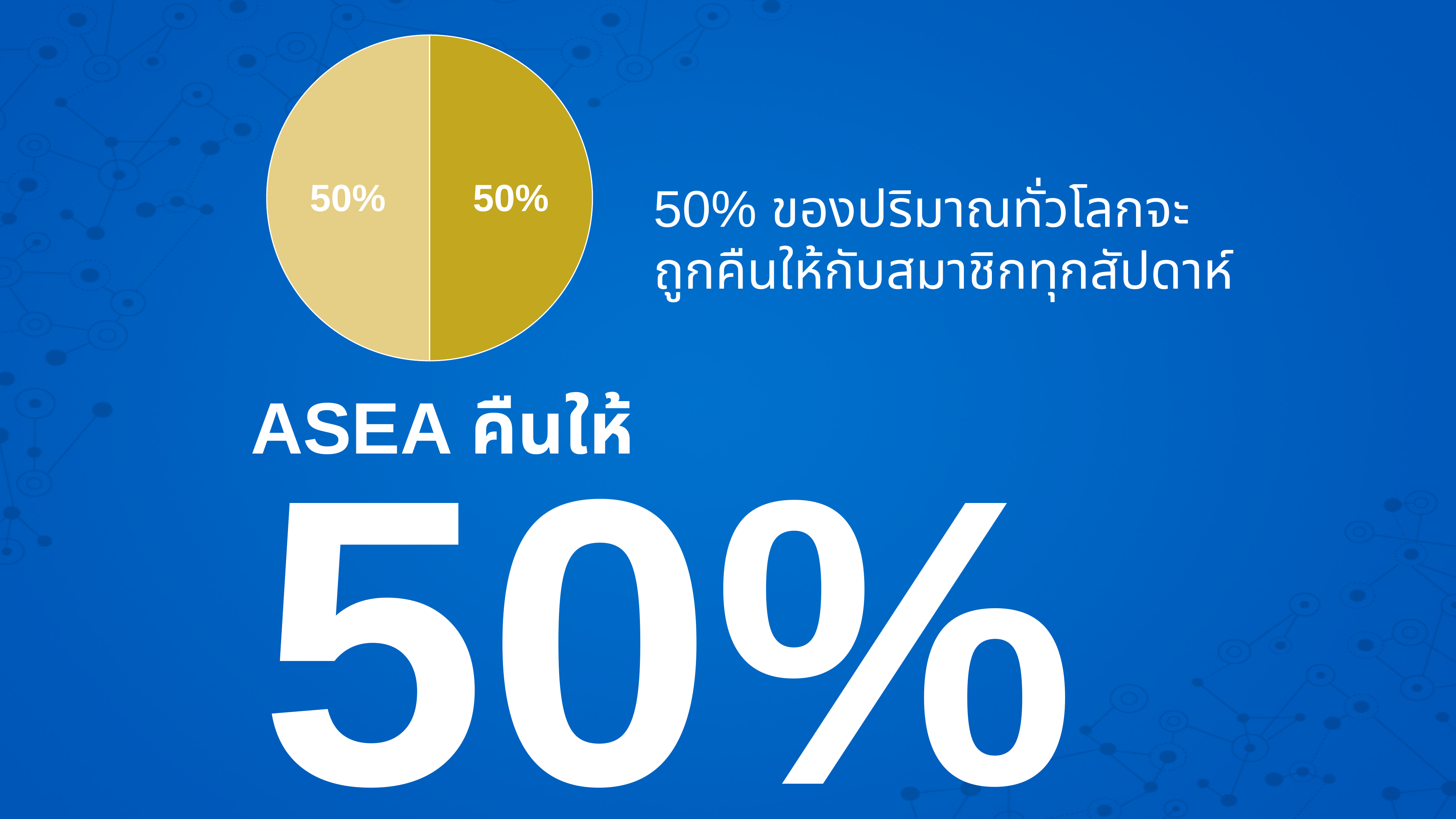
What colour family are the slices of the pie chart? gold What share of the pie does the right (darker) slice represent? 50% What kind of chart is shown on the slide? pie chart What is the data label shown on the right slice of the pie chart? 50% Does the pie chart have a legend? no How many slices does the pie chart have? 2 Are the two slices of the pie chart equal in size? yes What is the data label shown on the left slice of the pie chart? 50% What share of the pie does the left (lighter) slice represent? 50%